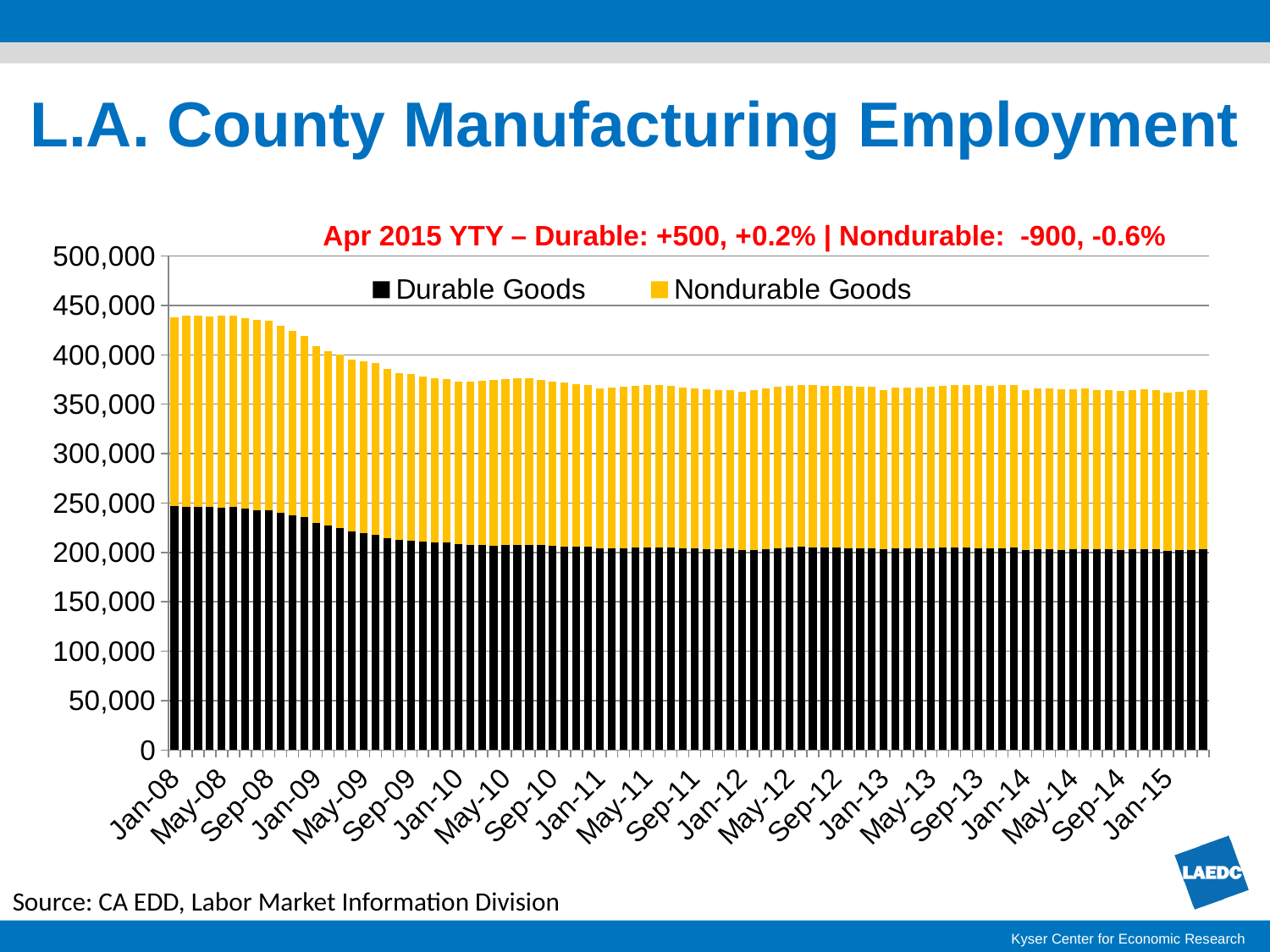
What are the two series named in the legend? Durable Goods and Nondurable Goods Is the total manufacturing employment for Jan-10 greater or less than 400,000? less Is the total manufacturing employment for Jan-15 greater or less than 400,000? less Which colour represents Nondurable Goods in the chart? Yellow Which month has the larger Durable Goods value, Jan-08 or Jan-13? Jan-08 What kind of chart is shown on the slide? Stacked bar chart Does total manufacturing employment rise or fall from Jan-08 to Jan-10? Fall Which month has the larger total manufacturing employment, Jan-08 or Jan-15? Jan-08 Is the Durable Goods value for Jan-15 greater or less than 250,000? less How many series does the legend list? 2